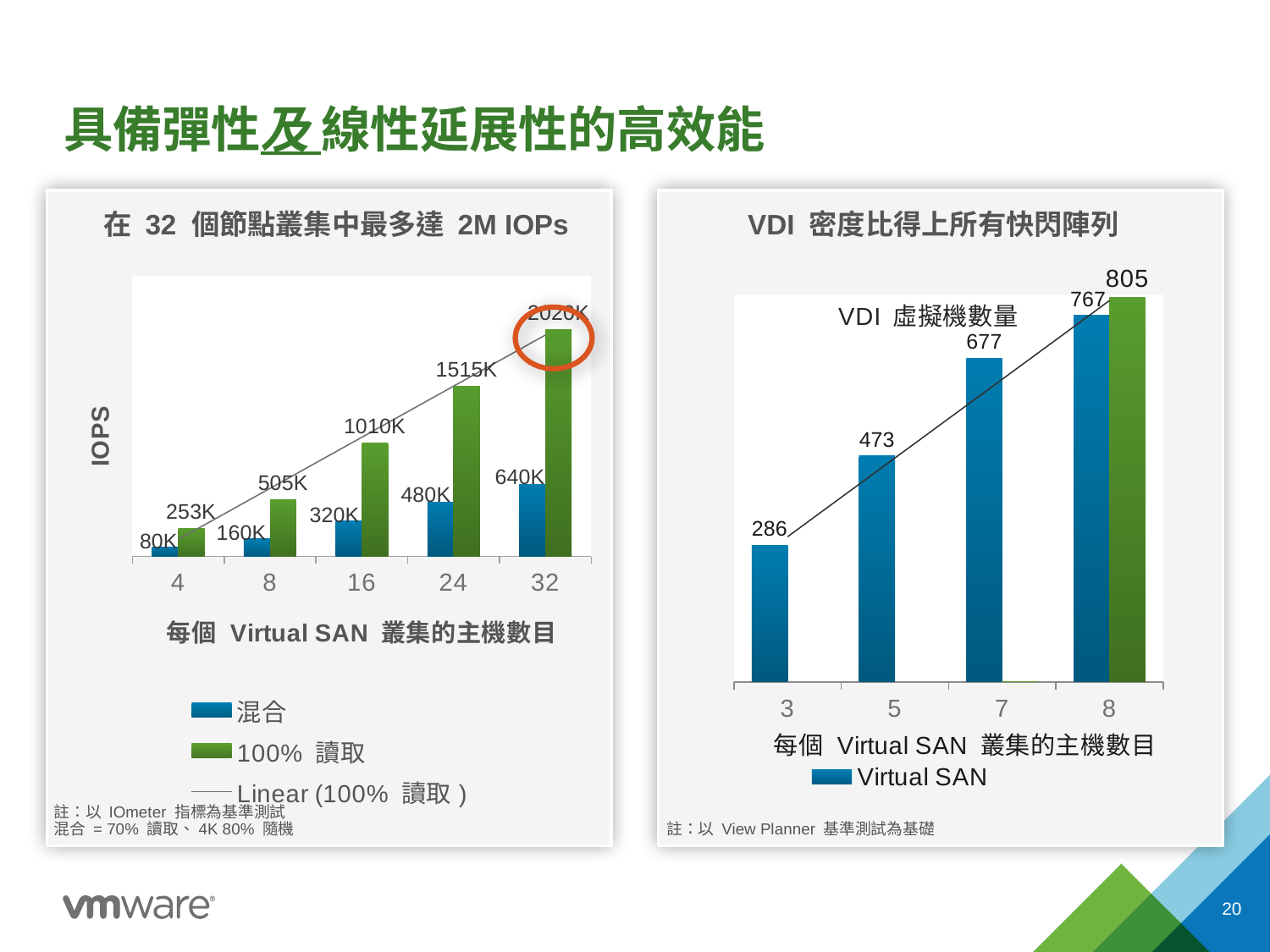
In the left chart (在 32 個節點叢集中最多達 2M IOPs), how many entries does the legend list? 3 In the left chart (在 32 個節點叢集中最多達 2M IOPs), at which host count is the 混合 value lowest? 4 In the left chart (在 32 個節點叢集中最多達 2M IOPs), what is the 100% 讀取 value at 24 hosts? 1515K In the left chart (在 32 個節點叢集中最多達 2M IOPs), at which host count is the 100% 讀取 value highest? 32 What type of chart is the right chart (VDI 密度比得上所有快閃陣列)? bar chart In the right chart (VDI 密度比得上所有快閃陣列), what is the difference between the values at 7 hosts and 3 hosts? 391 In the right chart (VDI 密度比得上所有快閃陣列), which is larger at 8 hosts: the blue bar or the green bar? the green bar (805) In the right chart (VDI 密度比得上所有快閃陣列), what is the blue Virtual SAN value at 5 hosts? 473 In the left chart (在 32 個節點叢集中最多達 2M IOPs), how many host-count categories are shown on the x axis? 5 In the left chart (在 32 個節點叢集中最多達 2M IOPs), do the 混合 values rise or fall as the number of hosts increases? rise In the left chart (在 32 個節點叢集中最多達 2M IOPs), what is the 混合 value at 16 hosts? 320K In the left chart (在 32 個節點叢集中最多達 2M IOPs), what is the difference between the 100% 讀取 and 混合 values at 8 hosts? 345K